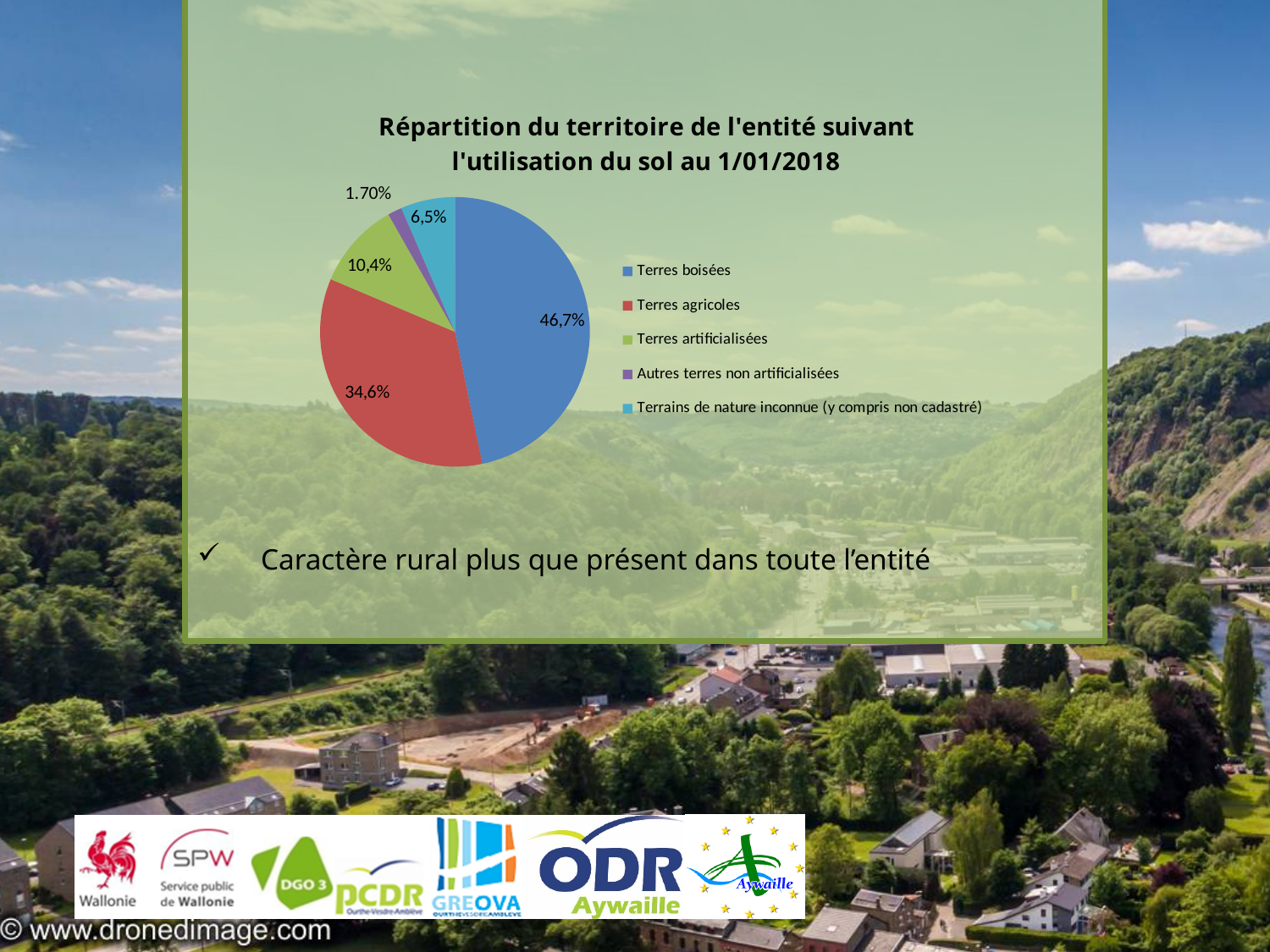
What is the share of Terres agricoles in the pie chart? 34,6% What is the share of Terres artificialisées in the pie chart? 10,4% Which is larger: the share of Terres agricoles or the share of Terres artificialisées? Terres agricoles What is the share of Autres terres non artificialisées in the pie chart? 1.70% Which category has the smallest slice of the pie chart? Autres terres non artificialisées What type of chart is shown on the slide? Pie chart How many categories does the legend of the pie chart list? 5 What is the share of Terrains de nature inconnue (y compris non cadastré) in the pie chart? 6,5% What is the title of the pie chart? Répartition du territoire de l'entité suivant l'utilisation du sol au 1/01/2018 What is the share of Terres boisées in the pie chart? 46,7% Which category has the largest slice of the pie chart? Terres boisées What is the difference in percentage points between Terres boisées and Terres agricoles? 12,1